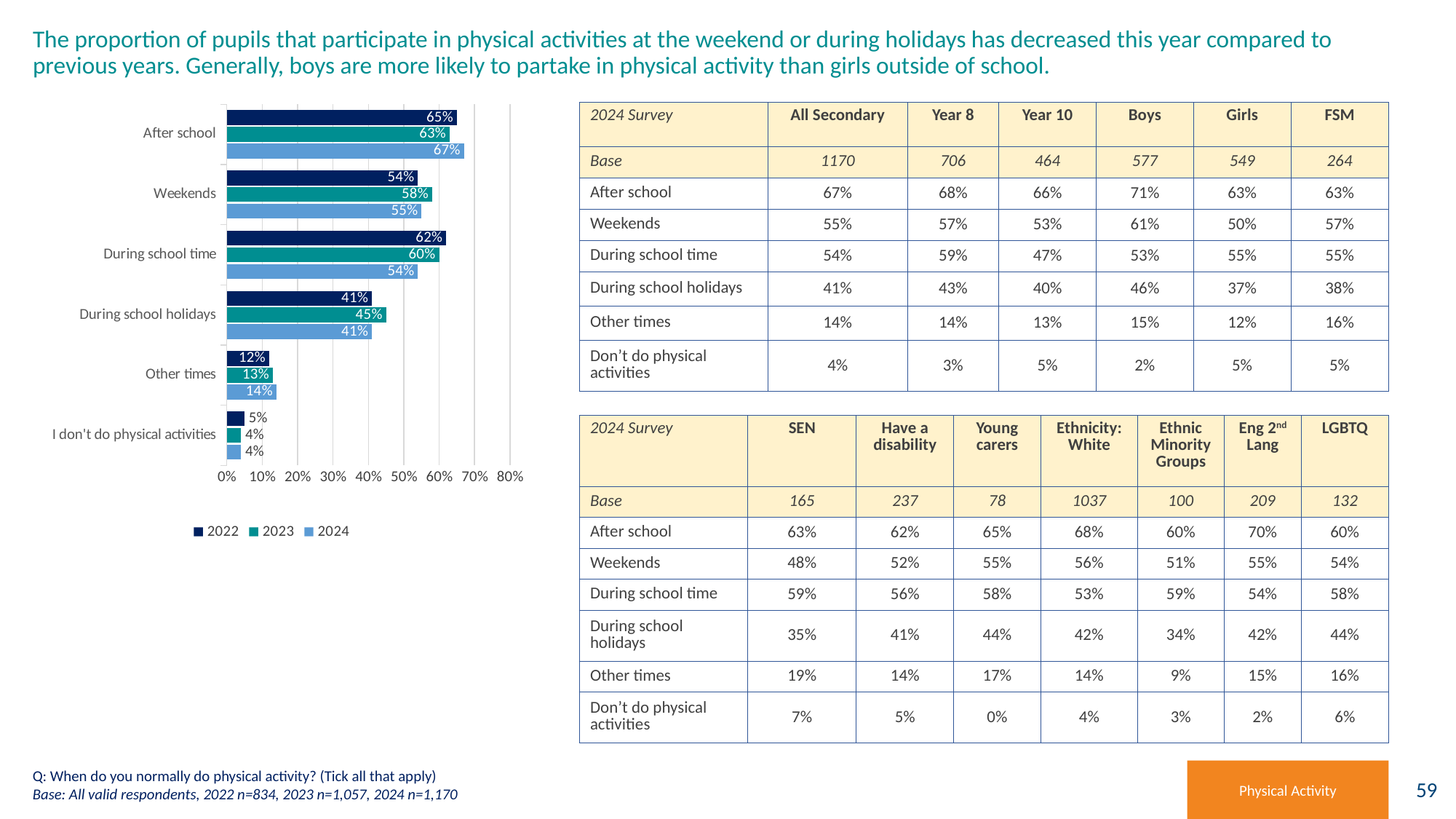
What kind of chart is shown on the slide? Bar chart How many series does the chart legend list? 3 What is the 2023 value for Weekends in the chart? 58% Is the 2024 value for Weekends greater or less than 50%? greater Which category has the lowest 2022 value in the chart? I don't do physical activities What is the 2022 value for During school time in the chart? 62% What is the difference between the 2022 and 2024 values for During school time? 8% Which category has the highest 2024 value in the chart? After school What is the 2024 value for After school in the chart? 67% Which is larger for During school holidays: the 2023 value or the 2024 value? 2023 How many categories are shown on the chart? 6 Which series is shown in the darkest blue in the chart legend? 2022